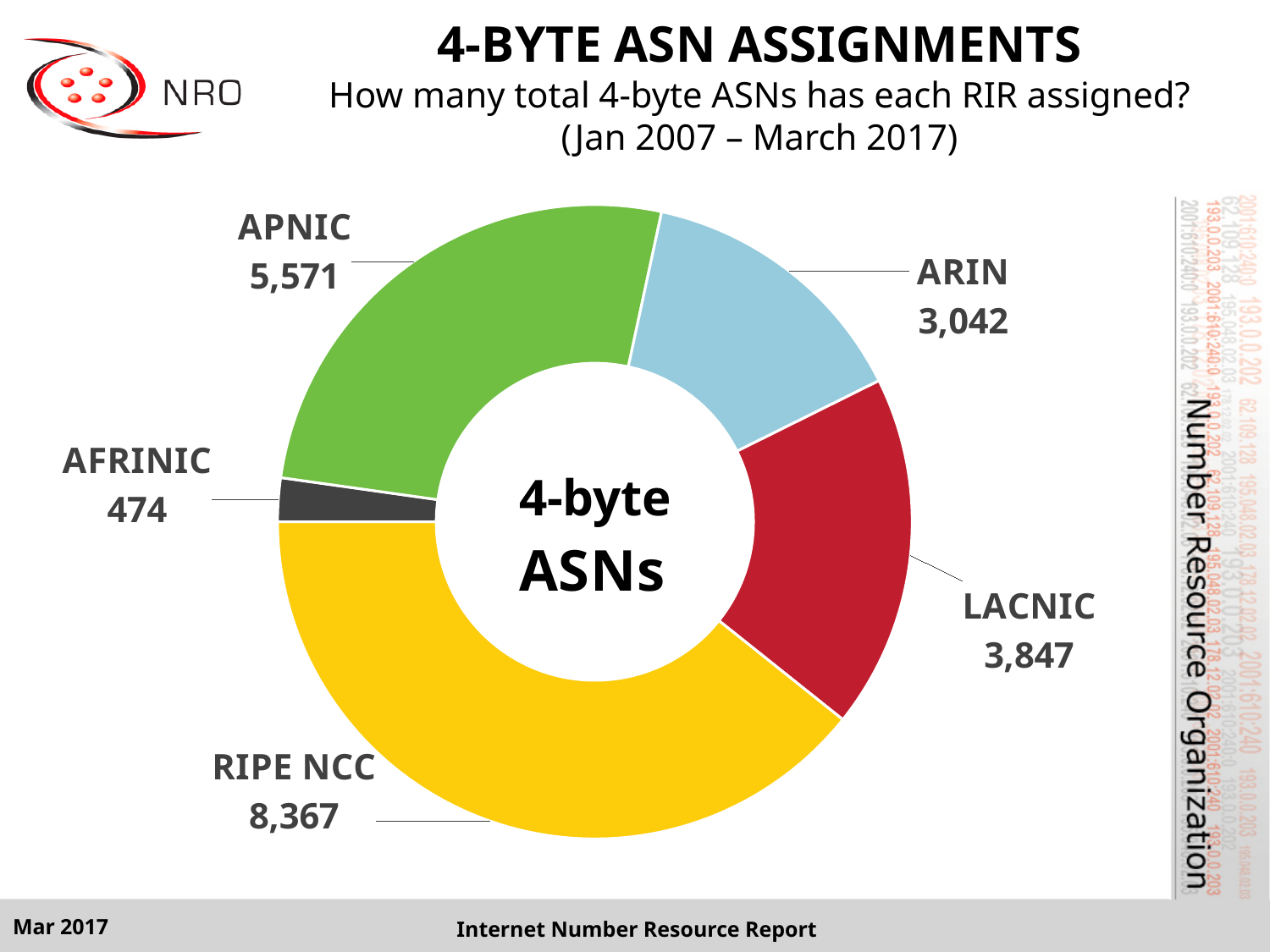
Which RIR has assigned the fewest 4-byte ASNs? AFRINIC Which RIR has assigned the most 4-byte ASNs? RIPE NCC What is the difference between the LACNIC and ARIN values? 805 What kind of chart is shown on the slide? Pie chart (donut) What text is written in the centre of the donut chart? 4-byte ASNs How many 4-byte ASNs has RIPE NCC assigned according to the chart? 8,367 What is the difference between the RIPE NCC and APNIC values? 2,796 What is the value shown for AFRINIC? 474 What is the value shown for APNIC? 5,571 How many RIRs (slices) are shown in the chart? 5 What is the value shown for LACNIC? 3,847 Which is larger, the value for ARIN or the value for LACNIC? LACNIC